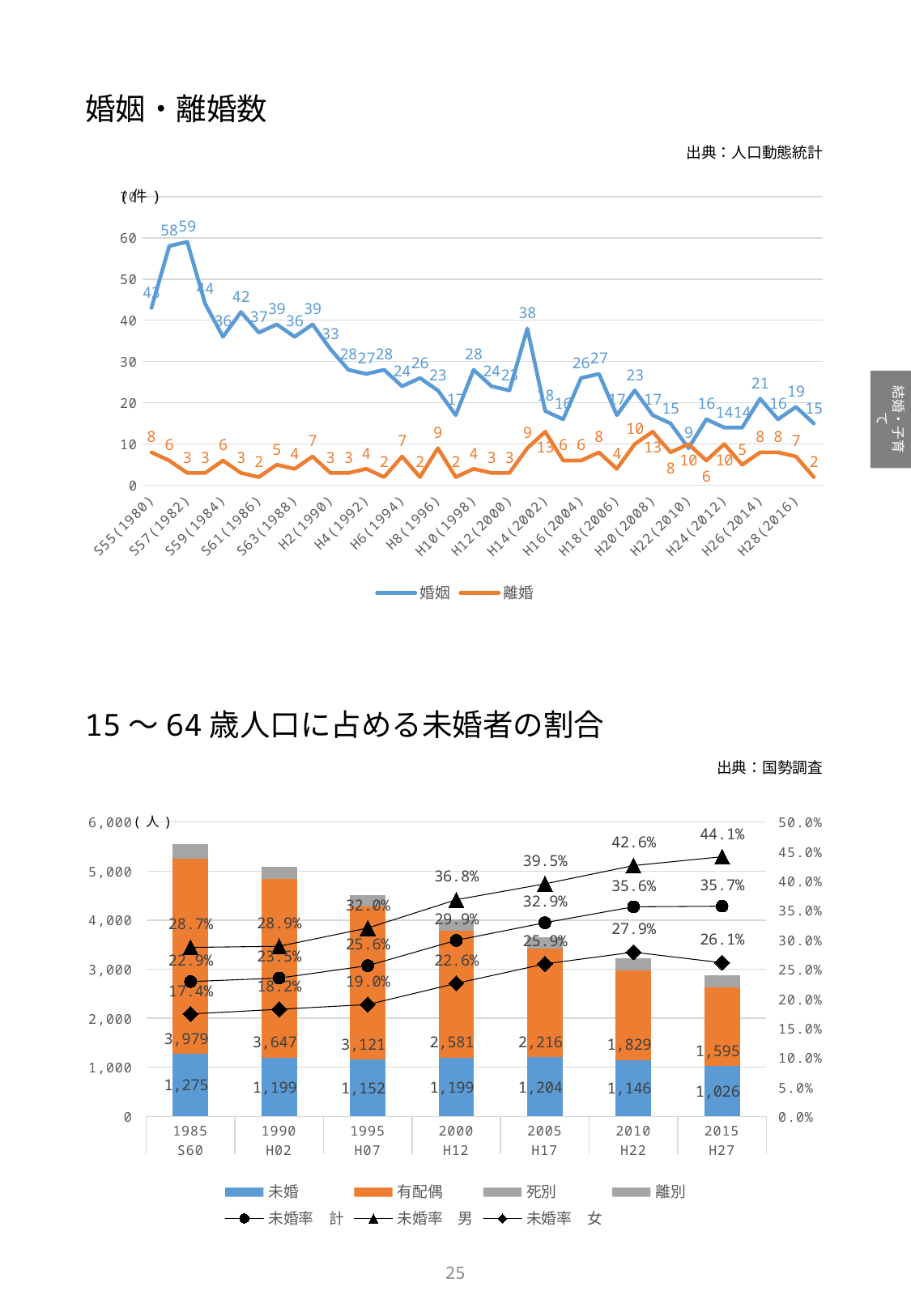
In the top chart (婚姻・離婚数), what is the value of 婚姻 for H22(2010)? 9 In the top chart (婚姻・離婚数), which year has the highest 婚姻 value? S57(1982) In the bottom chart (15～64歳人口に占める未婚者の割合), how many series does the legend list? 7 In the top chart (婚姻・離婚数), what kind of chart is it? line chart In the bottom chart (15～64歳人口に占める未婚者の割合), what is the 未婚 value for 2015 (H27)? 1,026 In the top chart (婚姻・離婚数), what is the value of 離婚 for S55(1980)? 8 In the bottom chart (15～64歳人口に占める未婚者の割合), what is the difference between the 有配偶 values for 1985 and 2015? 2,384 In the bottom chart (15～64歳人口に占める未婚者の割合), what is the 未婚率 男 value for 2010 (H22)? 42.6% In the bottom chart (15～64歳人口に占める未婚者の割合), which year has the highest 有配偶 value? 1985 (S60) In the bottom chart (15～64歳人口に占める未婚者の割合), does the 未婚率 男 line rise or fall from 1985 to 2015? rise In the top chart (婚姻・離婚数), what is the difference between the 婚姻 value for S57(1982) and the 婚姻 value for H28(2016)? 40 In the top chart (婚姻・離婚数), how many series does the legend list? 2